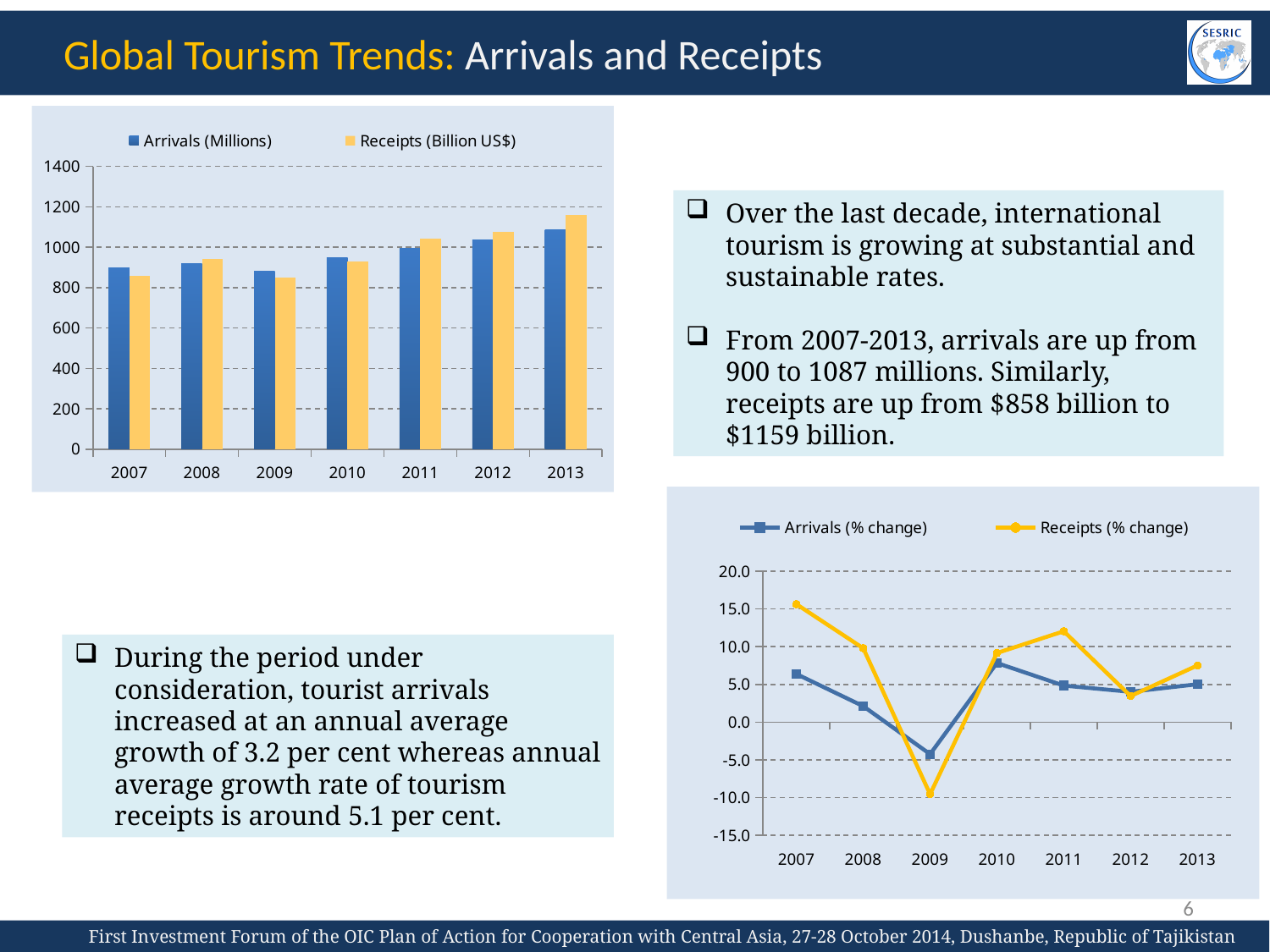
In the bottom-right line chart, which year has the highest Receipts (% change) value? 2007 In the top-left bar chart, how many years are shown on the x axis? 7 What kind of chart is the top-left chart showing Arrivals (Millions) and Receipts (Billion US$)? Bar chart In the bottom-right line chart, which year has the lowest Receipts (% change) value? 2009 In the bottom-right line chart, which series has the higher value in 2007, Arrivals (% change) or Receipts (% change)? Receipts (% change) In the top-left bar chart, which bar is taller in 2013, Arrivals (Millions) or Receipts (Billion US$)? Receipts (Billion US$) What kind of chart is the bottom-right chart showing Arrivals (% change) and Receipts (% change)? Line chart In the top-left bar chart, which year has the highest Arrivals (Millions) bar? 2013 In the top-left bar chart, how many series does the legend list? 2 In the bottom-right line chart, is the Arrivals (% change) value for 2009 greater or less than 0.0? less In the top-left bar chart, is the Receipts (Billion US$) value for 2013 greater or less than 1000? greater In the top-left bar chart, is the Receipts (Billion US$) value for 2007 greater or less than 1000? less